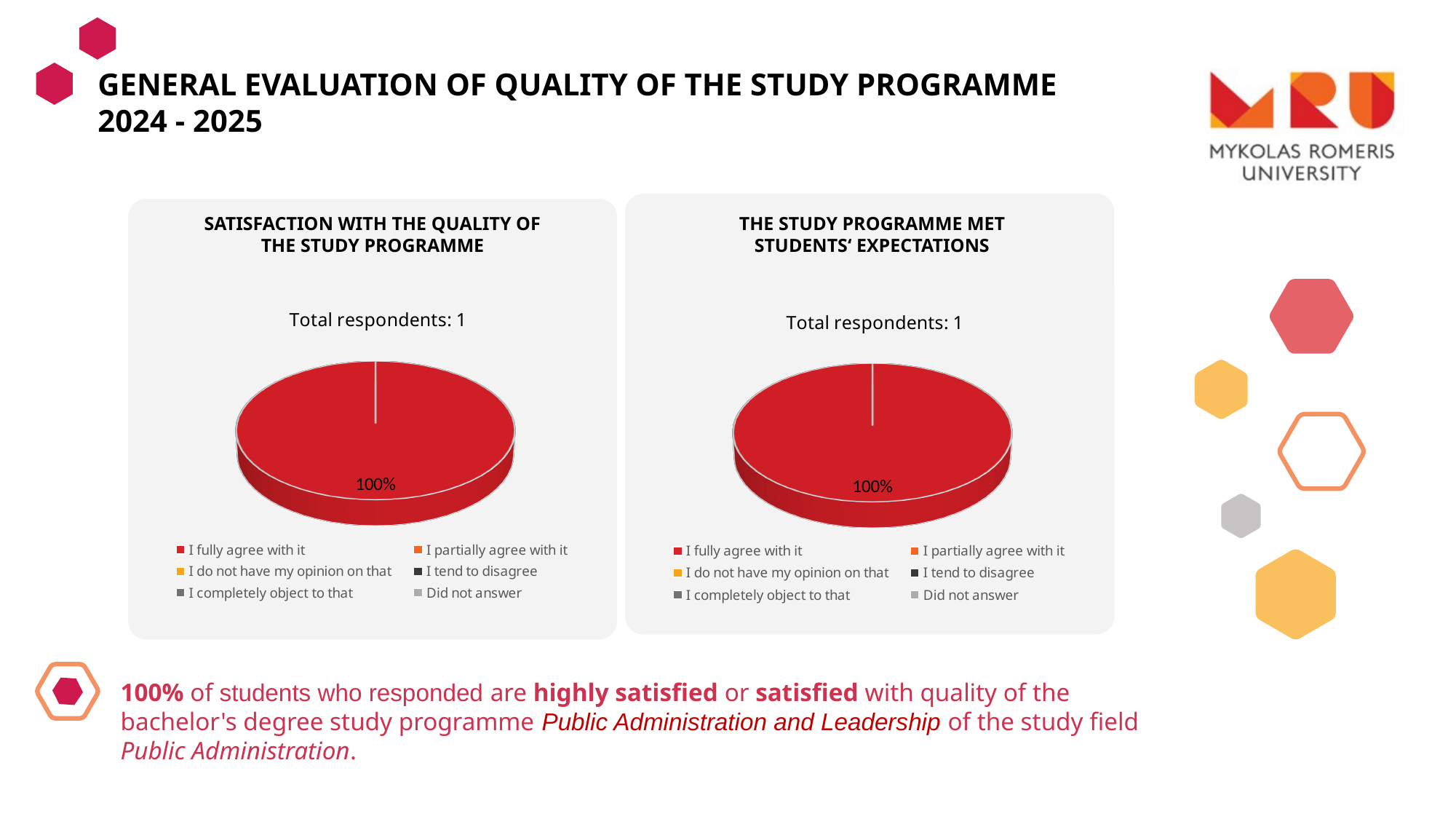
In the left chart, "Satisfaction with the quality of the study programme", how many total respondents are reported? 1 In the chart titled "Satisfaction with the quality of the study programme", what share of the pie is labelled 100%? I fully agree with it How many entries does the legend list in the chart titled "Satisfaction with the quality of the study programme"? 6 In the chart titled "The study programme met students' expectations", which legend category accounts for the largest share of the pie? I fully agree with it What type of chart is used in the left panel, "Satisfaction with the quality of the study programme"? Pie chart In the chart titled "Satisfaction with the quality of the study programme", which legend category accounts for the largest share of the pie? I fully agree with it What is the title of the chart on the right side of the slide? The study programme met students' expectations In the left chart, "Satisfaction with the quality of the study programme", what colour is the legend marker for "I do not have my opinion on that"? Yellow/orange In the chart titled "The study programme met students' expectations", what percentage is shown on the pie? 100% How many entries does the legend list in the chart titled "The study programme met students' expectations"? 6 What type of chart is used in the right panel, "The study programme met students' expectations"? Pie chart In the right chart, "The study programme met students' expectations", how many total respondents are reported? 1